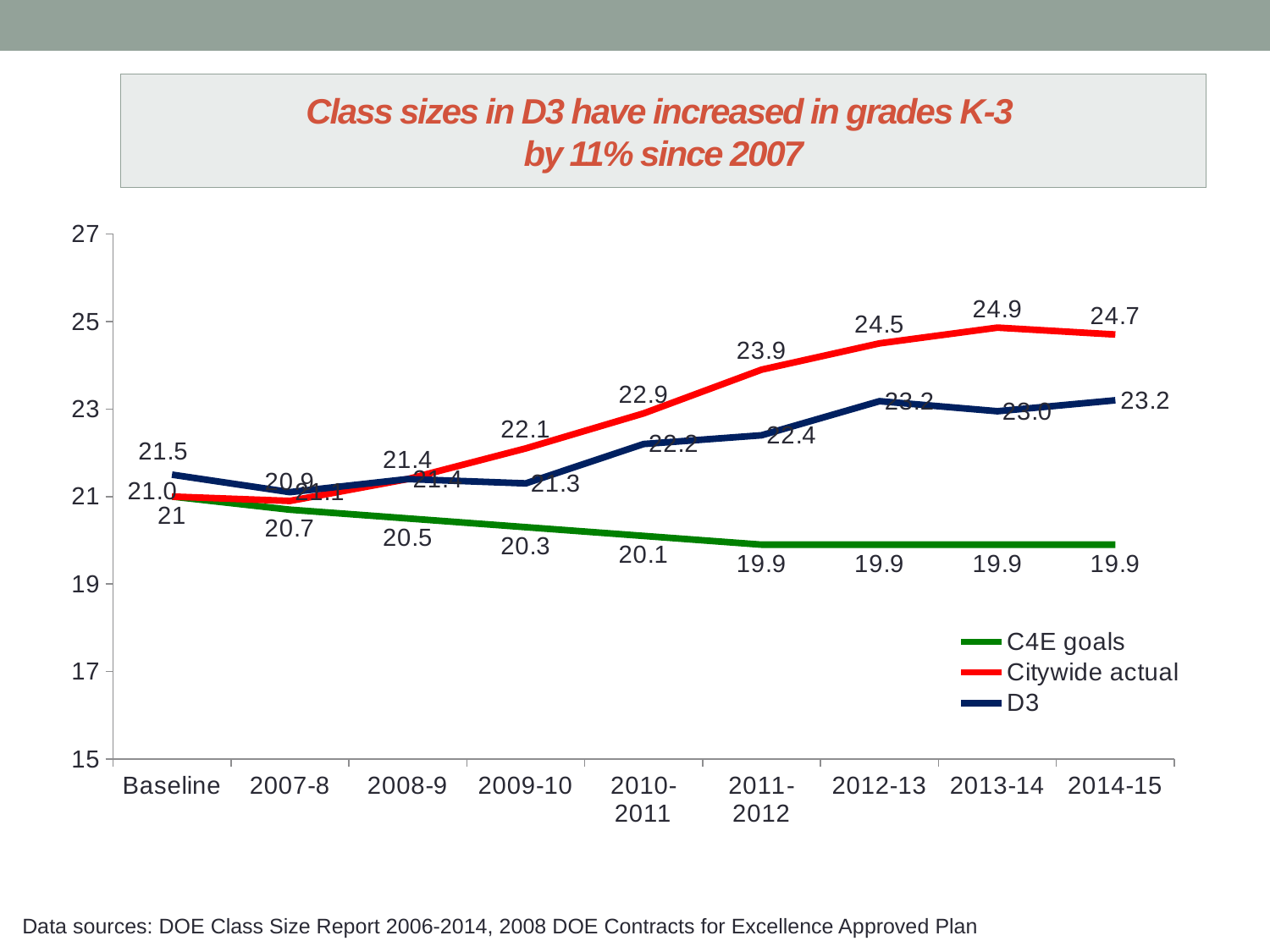
How many series does the legend list? 3 What is the D3 value at Baseline? 21.5 Does the C4E goals series rise or fall from Baseline to 2014-15? fall What kind of chart is shown on the slide? line chart What is the difference between the Citywide actual value and the C4E goals value in 2014-15? 4.8 What is the C4E goals value for 2014-15? 19.9 What colour is the line for the D3 series? dark blue In which year does the Citywide actual series reach its highest value? 2013-14 What is the Citywide actual value for 2010-2011? 22.9 What is the Citywide actual value for 2013-14? 24.9 In 2012-13, which is larger: the Citywide actual value or the D3 value? Citywide actual How many points are plotted along the x axis for each series? 9